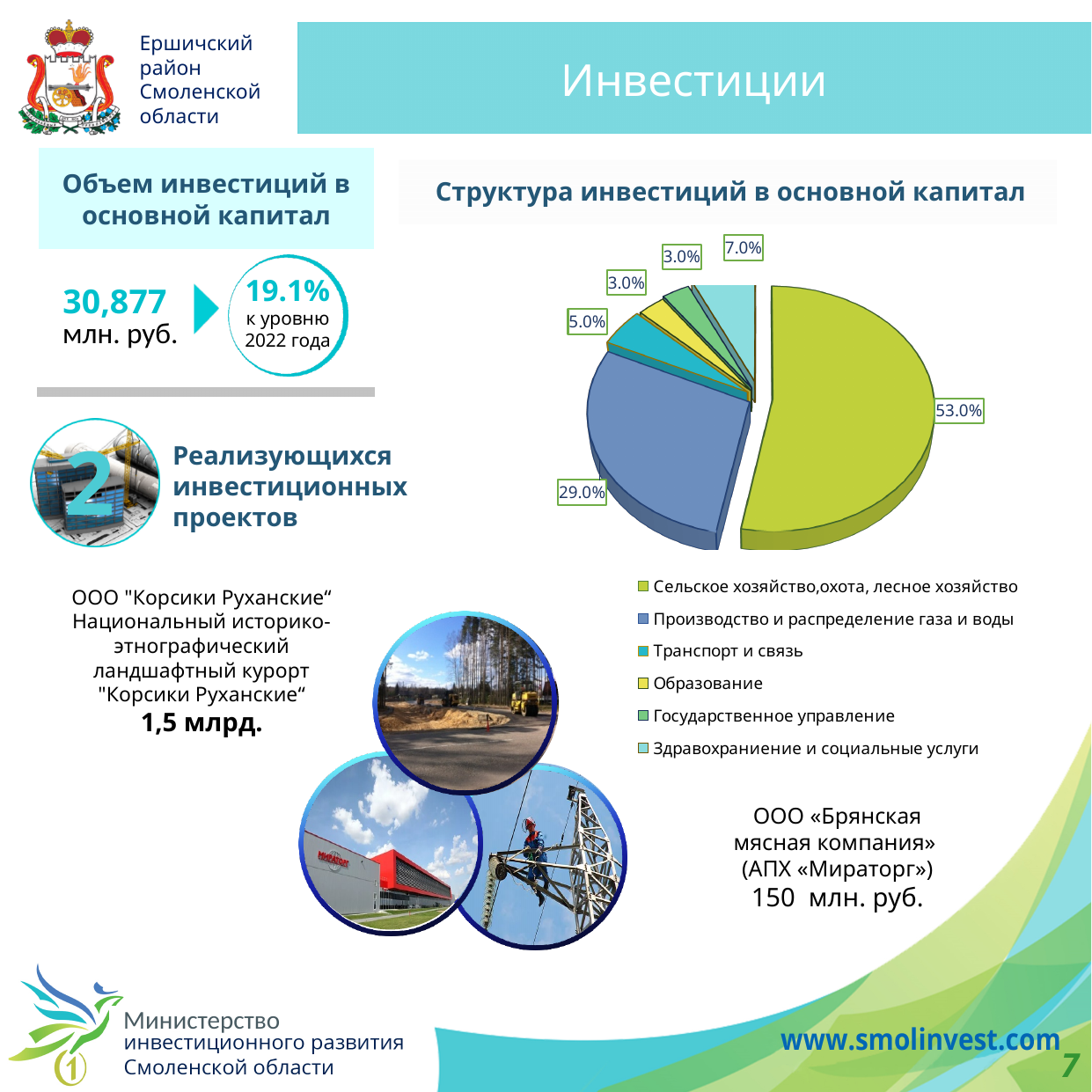
Which category has the largest slice in the pie chart? Сельское хозяйство,охота, лесное хозяйство In the pie chart, what share is labelled for "Здравоохранение и социальные услуги"? 7.0% How many categories does the legend of the pie chart list? 6 In the pie chart, what share is labelled for "Производство и распределение газа и воды"? 29.0% In the pie chart, what share is labelled for "Сельское хозяйство,охота, лесное хозяйство"? 53.0% In the pie chart, what is the difference between the shares of "Сельское хозяйство,охота, лесное хозяйство" and "Производство и распределение газа и воды"? 24.0% In the pie chart, what share is labelled for "Образование"? 3.0% In the pie chart, which is larger: the share of "Здравоохранение и социальные услуги" or the share of "Транспорт и связь"? Здравоохранение и социальные услуги In the pie chart, what share is labelled for "Транспорт и связь"? 5.0% What kind of chart is shown under the title "Структура инвестиций в основной капитал"? pie chart In the pie chart, what is the combined share of "Образование" and "Государственное управление"? 6.0% What colour is the slice for "Производство и распределение газа и воды" in the pie chart? blue